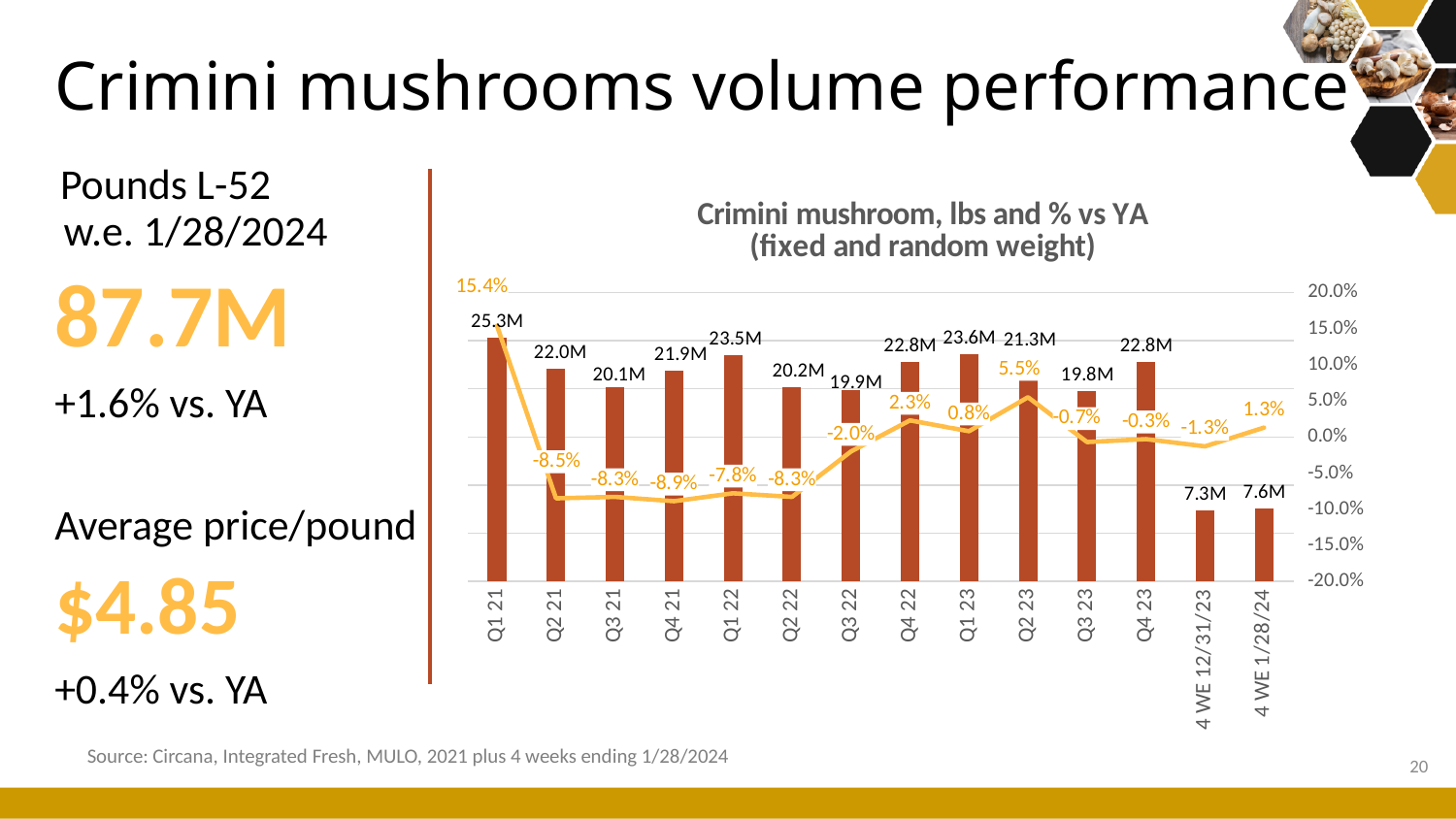
What is the pounds value for Q1 21? 25.3M What is the title of the chart? Crimini mushroom, lbs and % vs YA (fixed and random weight) How many periods are shown on the x axis? 14 Which period has the lowest pounds value? 4 WE 12/31/23 Which period has the highest pounds value? Q1 21 Which period has the highest % vs YA value? Q1 21 What is the difference in pounds between Q1 23 and Q3 23? 3.8M What type of chart is used to show the pounds values? Bar chart What is the % vs YA value for Q4 21? -8.9% What is the pounds value for the 4 WE 1/28/24 period? 7.6M What is the % vs YA value for Q2 23? 5.5% Which is larger, the pounds value for Q4 22 or Q2 23? Q4 22